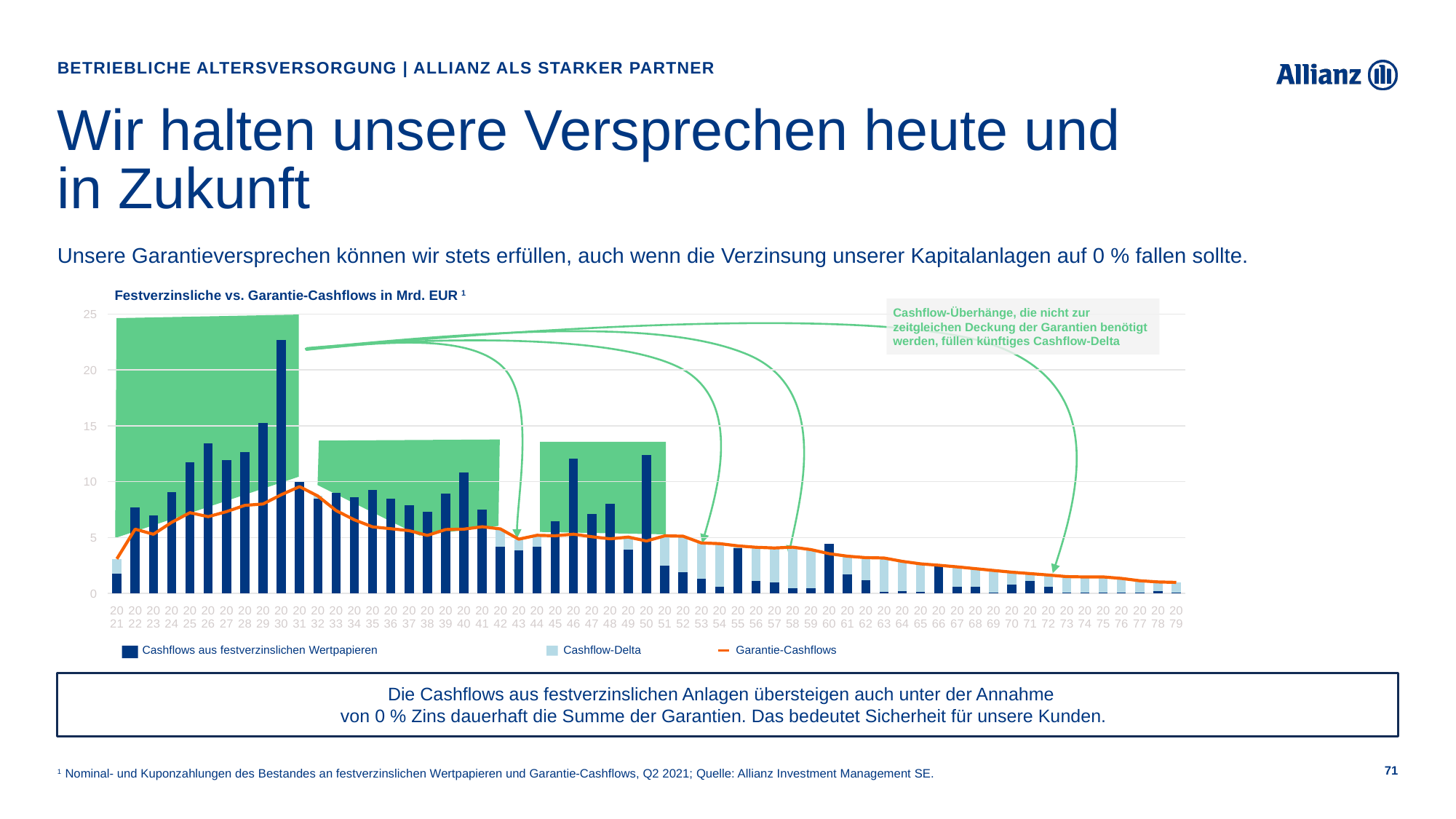
Which series is drawn as an orange line in the chart? Garantie-Cashflows Is the value for Cashflows aus festverzinslichen Wertpapieren in 2021 greater or less than 5? less What is the title of the chart? Festverzinsliche vs. Garantie-Cashflows in Mrd. EUR What kind of chart is shown on the slide? Bar chart with a line Which year has the larger bar for Cashflows aus festverzinslichen Wertpapieren, 2030 or 2031? 2030 Is the value for Cashflows aus festverzinslichen Wertpapieren in 2030 greater or less than 20? greater How many series does the chart legend list? 3 Does the Garantie-Cashflows line rise or fall from 2031 to 2079? Fall Is the value for Cashflows aus festverzinslichen Wertpapieren in 2046 greater or less than 10? greater How many years are shown along the x axis of the chart? 59 Which year has the highest bar for Cashflows aus festverzinslichen Wertpapieren? 2030